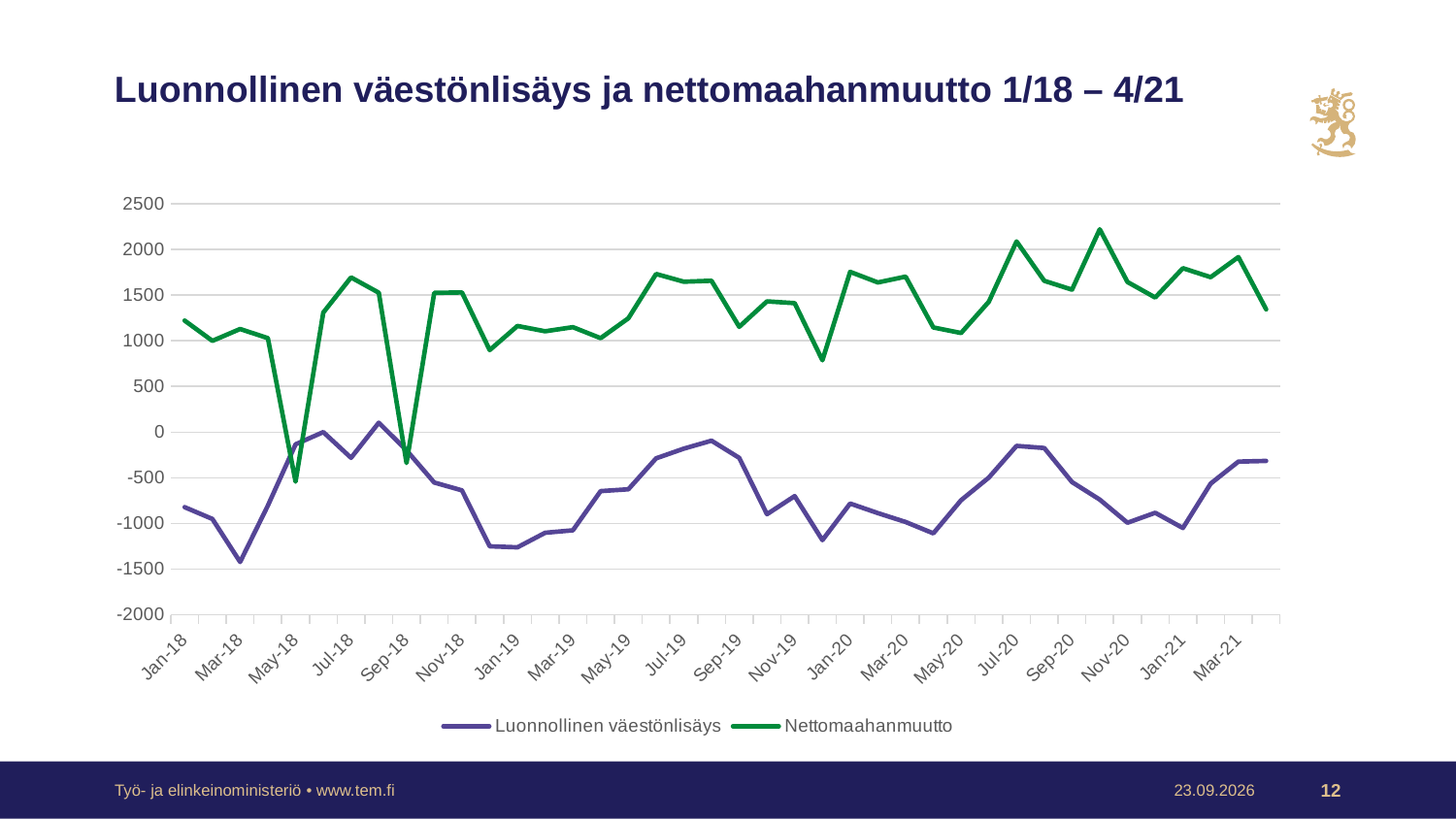
Which series is drawn with the green line? Nettomaahanmuutto Which series has the higher value at May-18? Luonnollinen väestönlisäys Is the value of Nettomaahanmuutto at Jan-20 greater or less than 1500? greater Is the value of Nettomaahanmuutto at May-18 greater or less than 0? less What kind of chart is shown on the slide? line chart Does Luonnollinen väestönlisäys rise or fall from Jan-18 to Mar-18? fall Is the value of Luonnollinen väestönlisäys at Jan-19 greater or less than -1000? less What is the title of the chart? Luonnollinen väestönlisäys ja nettomaahanmuutto 1/18 – 4/21 How many series does the legend list? 2 Which series has the higher value at Jan-18? Nettomaahanmuutto